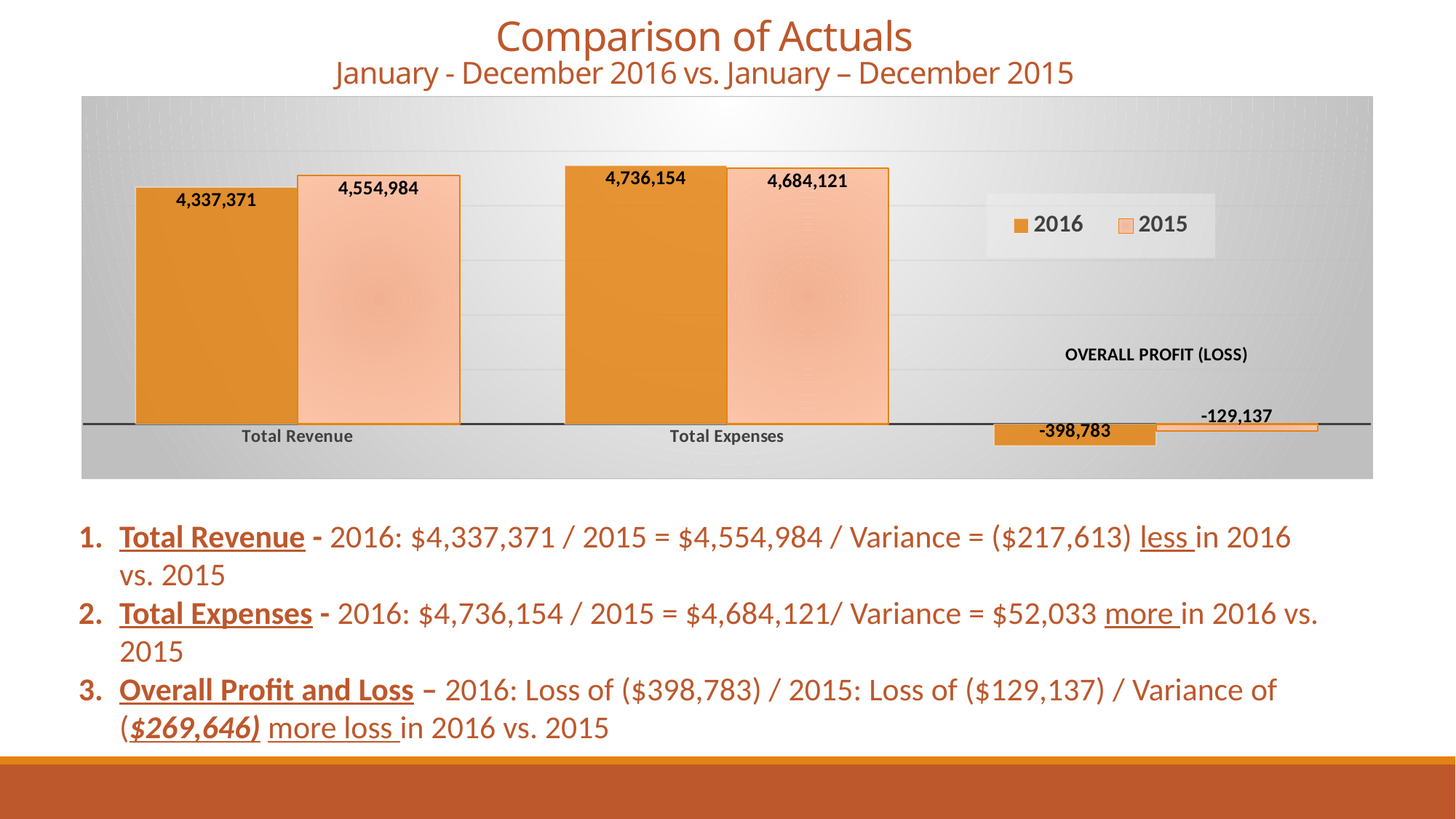
Which category has the lowest 2015 value? Overall Profit (Loss) How many series does the legend list? 2 What is the difference between the 2015 and 2016 values for Total Revenue? 217,613 What is the 2016 value for Overall Profit (Loss)? -398,783 What kind of chart is shown on the slide? Bar chart Which category has the highest 2016 value? Total Expenses Which is larger for Total Revenue, the 2016 value or the 2015 value? 2015 What is the 2015 value for Overall Profit (Loss)? -129,137 How many categories are shown on the x axis? 3 What is the difference between the 2016 and 2015 values for Total Expenses? 52,033 What is the 2015 value for Total Expenses? 4,684,121 What is the 2016 value for Total Revenue? 4,337,371